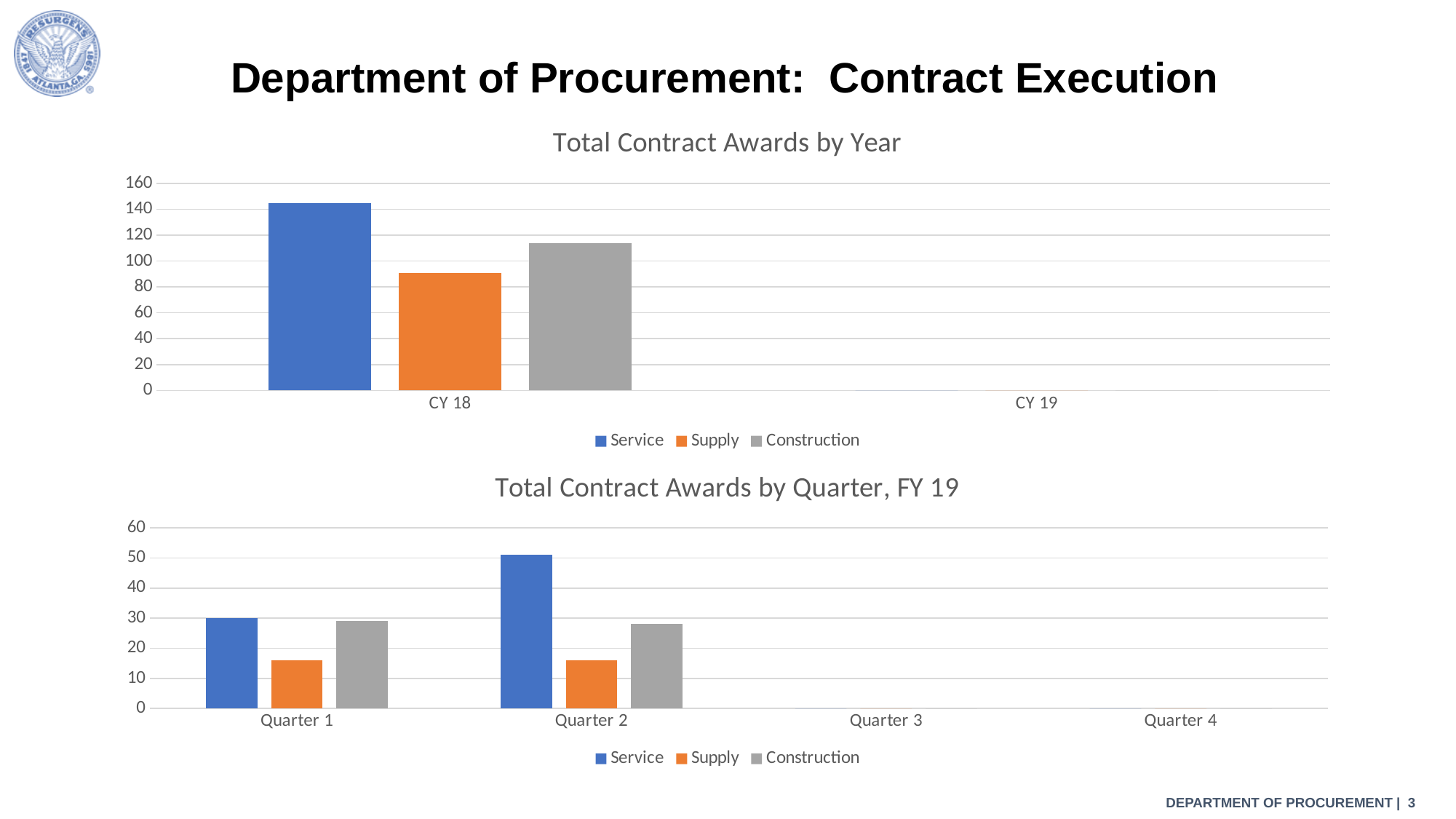
In the 'Total Contract Awards by Year' chart, which series has the highest value for CY 18? Service In the 'Total Contract Awards by Quarter, FY 19' chart, is the Supply value for Quarter 1 greater or less than 20? less In the 'Total Contract Awards by Year' chart, is the Supply value for CY 18 greater or less than 100? less In the 'Total Contract Awards by Quarter, FY 19' chart, which is larger: the Service value for Quarter 1 or the Service value for Quarter 2? Quarter 2 In the 'Total Contract Awards by Year' chart, is the Construction value for CY 18 greater or less than 100? greater In the 'Total Contract Awards by Quarter, FY 19' chart, which colour represents the Supply series? Orange In the 'Total Contract Awards by Year' chart, which series has the lowest value for CY 18? Supply In the 'Total Contract Awards by Quarter, FY 19' chart, how many quarters are shown on the x axis? 4 In the 'Total Contract Awards by Year' chart, how many series does the legend list? 3 What kind of chart is 'Total Contract Awards by Quarter, FY 19'? Bar chart